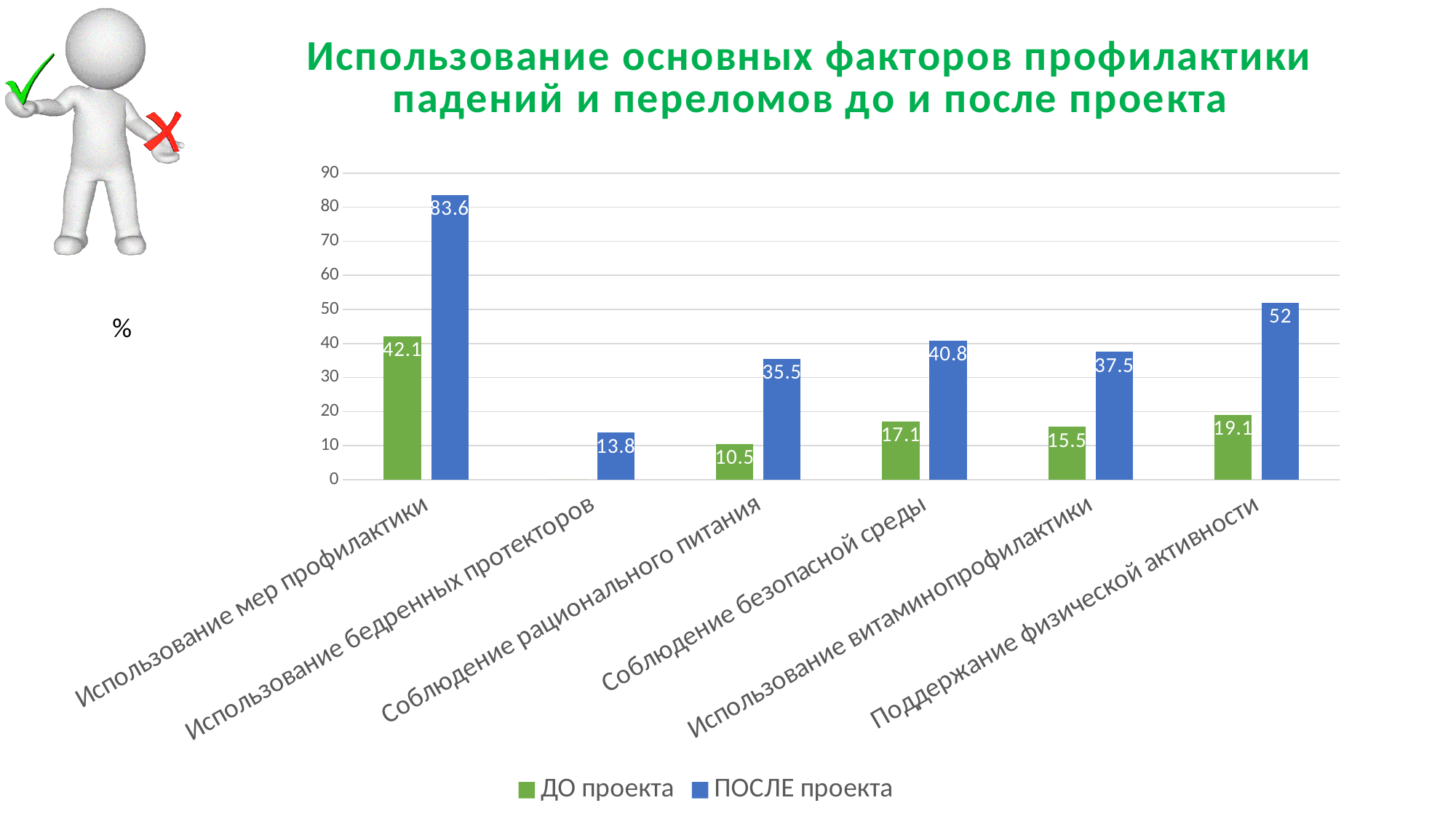
What is the value for "ДО проекта" in the category "Соблюдение рационального питания"? 10.5 Which is larger: the "ДО проекта" value for "Соблюдение безопасной среды" or the "ДО проекта" value for "Поддержание физической активности"? Поддержание физической активности What is the difference between the "ПОСЛЕ проекта" and "ДО проекта" values for "Использование мер профилактики"? 41.5 How many series does the legend list? 2 Which category has the highest value for "ПОСЛЕ проекта"? Использование мер профилактики How many categories are shown on the x axis of the chart? 6 Which category has the lowest value for "ПОСЛЕ проекта"? Использование бедренных протекторов Is the "ПОСЛЕ проекта" value for "Соблюдение безопасной среды" greater or less than 30? greater What is the value for "ДО проекта" in the category "Использование витаминопрофилактики"? 15.5 What kind of chart is shown on the slide? bar chart What is the value for "ПОСЛЕ проекта" in the category "Использование мер профилактики"? 83.6 What is the value for "ПОСЛЕ проекта" in the category "Поддержание физической активности"? 52